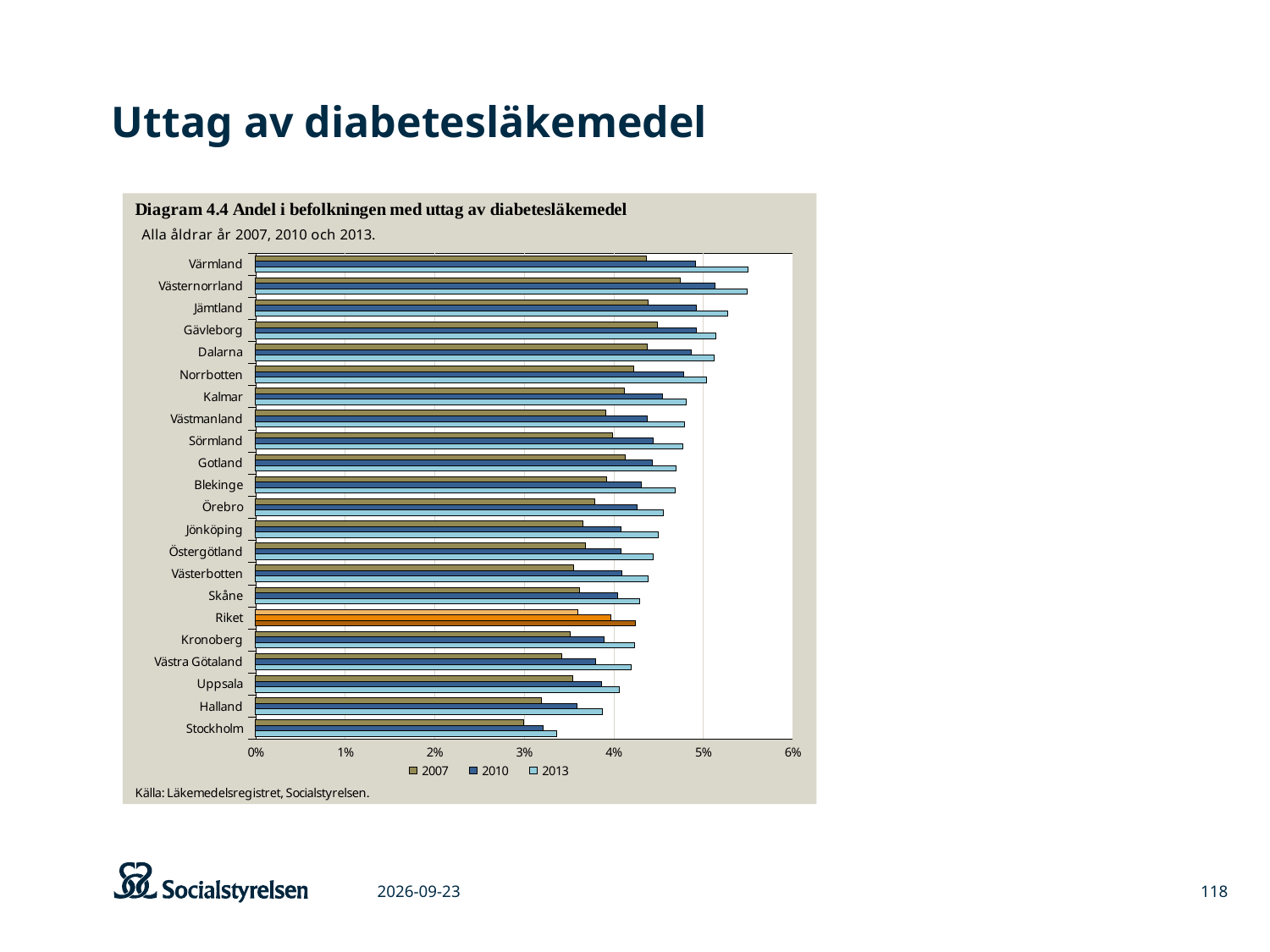
Which region has the lowest 2013 value? Stockholm How many series does the legend list? 3 Is the 2013 value for Stockholm greater or less than 4%? less Is the 2013 value for Värmland greater or less than 5%? greater Is the 2007 value for Västra Götaland greater or less than 4%? less How many regions (categories) are shown on the y axis? 22 Which category is highlighted with orange bars instead of the standard colours? Riket What kind of chart is shown on the slide? bar chart Which years are listed in the legend? 2007, 2010, 2013 Which is larger, the 2013 value for Värmland or the 2013 value for Stockholm? Värmland